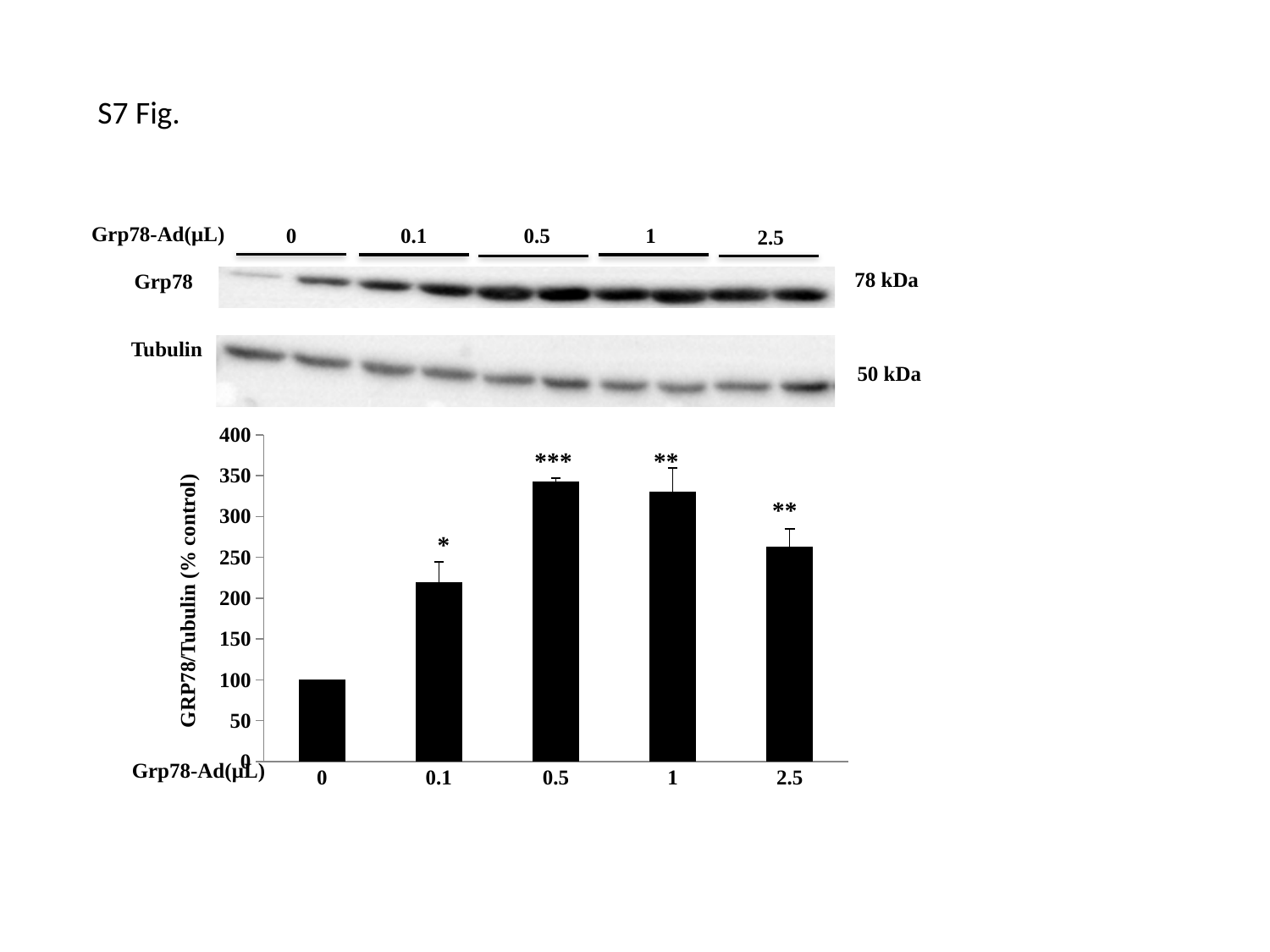
Which significance marker is shown above the bar for Grp78-Ad 0.5 µL? *** Which Grp78-Ad concentration has the highest GRP78/Tubulin (% control) value? 0.5 Which Grp78-Ad concentration has the lowest GRP78/Tubulin (% control) value? 0 Is the value for Grp78-Ad 0.1 µL greater or less than 200? greater How many bars are plotted in the chart? 5 Is the value for Grp78-Ad 0.5 µL greater or less than 300? greater What type of chart is shown on the slide? bar chart What is the label of the y axis of the chart? GRP78/Tubulin (% control) Which has a larger GRP78/Tubulin (% control) value, Grp78-Ad 0.1 µL or 2.5 µL? 2.5 Do the values rise or fall from Grp78-Ad 0 µL to 0.5 µL? rise What is the value of GRP78/Tubulin (% control) for Grp78-Ad 0 µL? 100 Is the value for Grp78-Ad 2.5 µL greater or less than 300? less